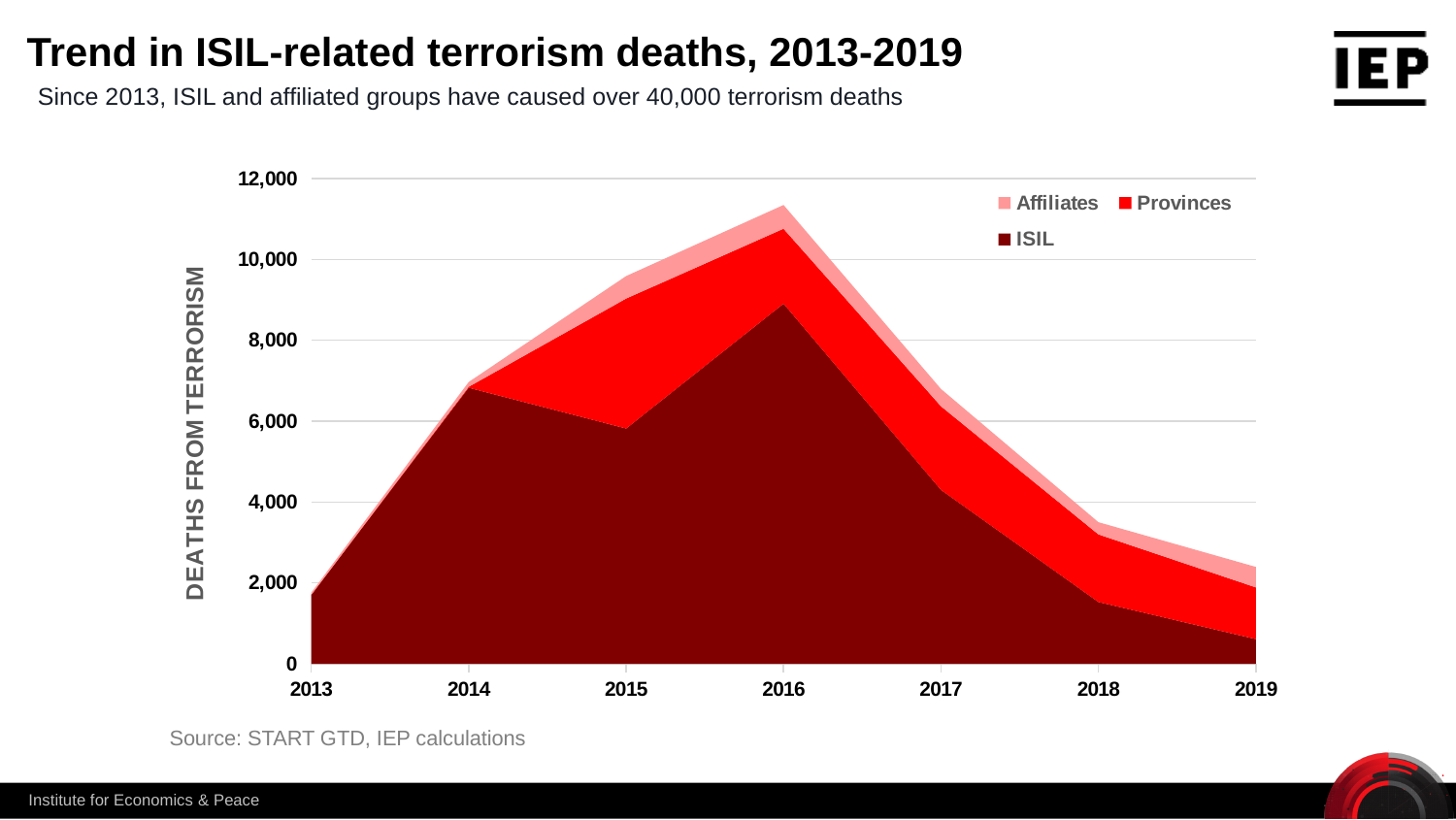
In which year do total ISIL-related terrorism deaths reach their highest point? 2016 Do total deaths rise or fall from 2016 to 2019? Fall How many years are shown along the x axis? 7 Is the total number of deaths in 2016 greater or less than 10,000? greater Which year has a higher total of deaths, 2014 or 2018? 2014 Is the number of deaths attributed to ISIL in 2016 greater or less than 8,000? greater What kind of chart is shown on the slide? Area chart Is the total number of deaths in 2018 greater or less than 4,000? less In which year are total ISIL-related terrorism deaths lowest? 2013 What is the label on the y axis? DEATHS FROM TERRORISM How many series does the legend list? 3